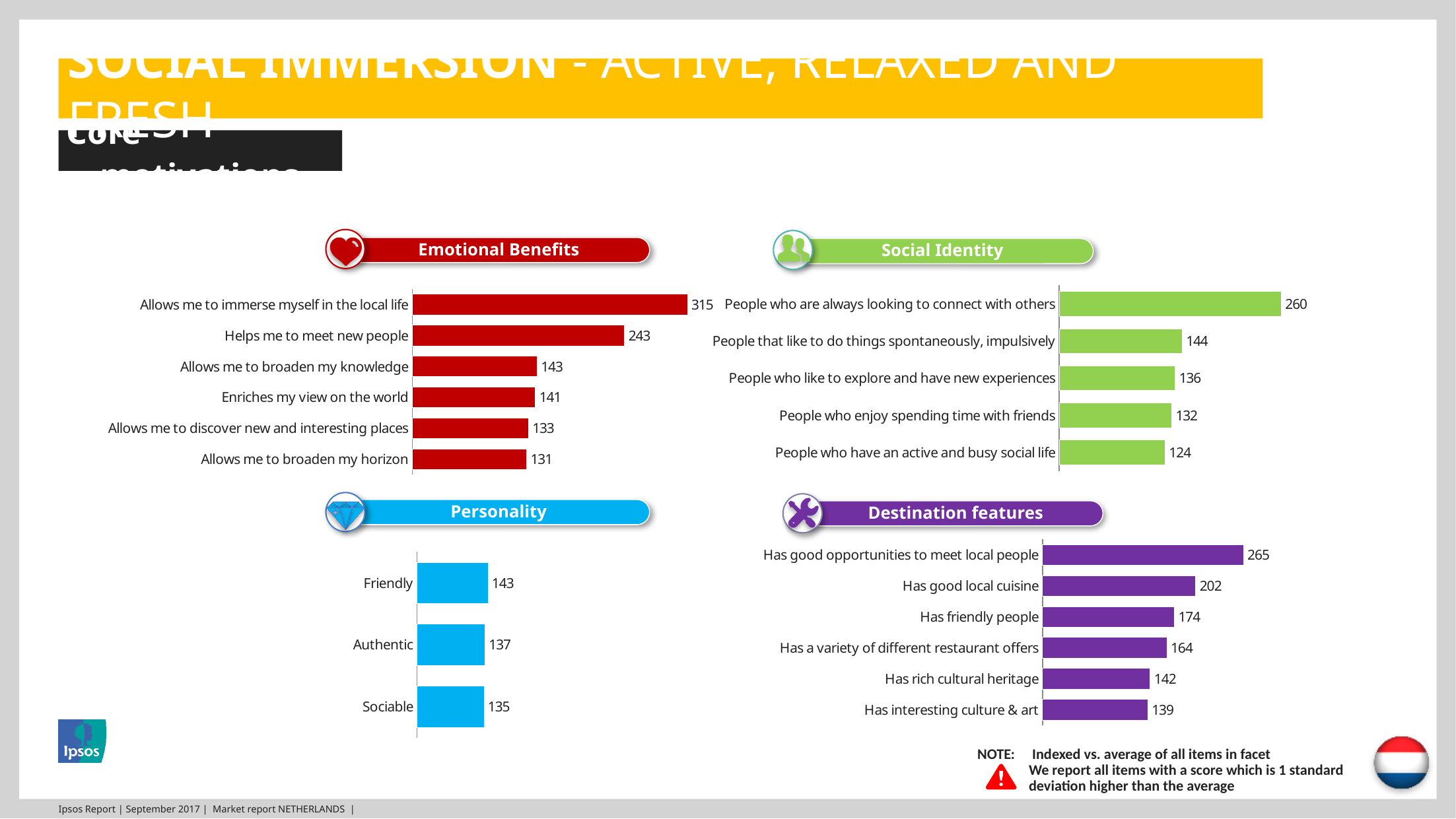
How many categories are shown in the Destination features chart? 6 In the Emotional Benefits chart, which category has the lowest value? Allows me to broaden my horizon How many categories are shown in the Social Identity chart? 5 In the Emotional Benefits chart, what is the difference between "Allows me to immerse myself in the local life" and "Helps me to meet new people"? 72 In the Destination features chart, what is the difference between "Has friendly people" and "Has rich cultural heritage"? 32 In the Social Identity chart, what is the value for "People who enjoy spending time with friends"? 132 In the Social Identity chart, which category has the highest value? People who are always looking to connect with others In the Emotional Benefits chart, what is the value for "Allows me to immerse myself in the local life"? 315 In the Personality chart, what is the value for "Authentic"? 137 In the Personality chart, which is larger, "Friendly" or "Sociable"? Friendly What kind of chart is the Personality chart? Bar chart In the Destination features chart, what is the value for "Has good local cuisine"? 202